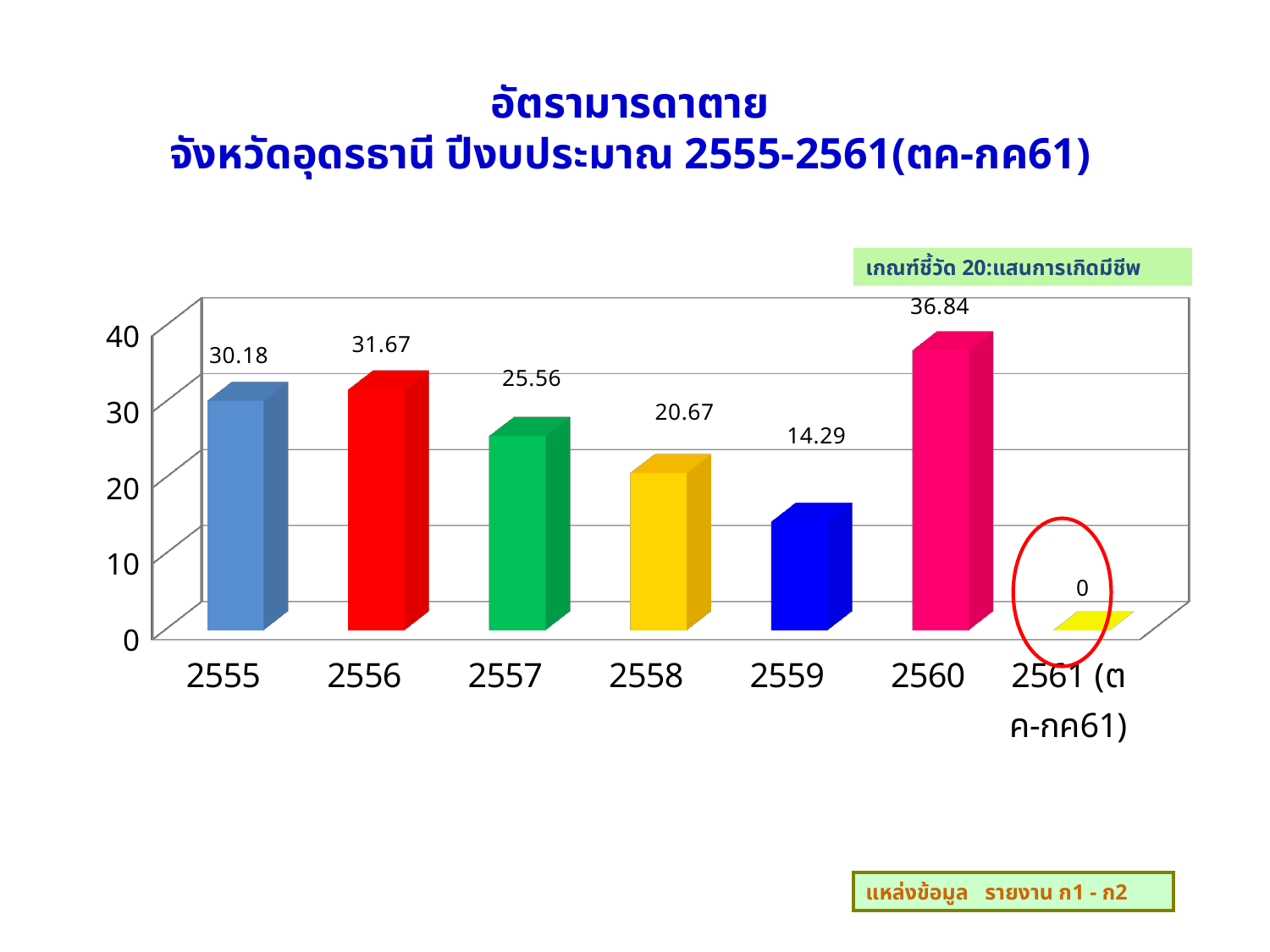
What is the value for 2560? 36.84 What kind of chart is shown on the slide? bar chart What is the value for 2558? 20.67 Which year has the highest value? 2560 Is the value for 2560 greater or less than 30? greater Do the values rise or fall from 2556 to 2559? fall Which is larger, the value for 2559 or the value for 2558? 2558 What is the value for 2555? 30.18 Which category has the lowest value? 2561 (ตค-กค61) How many categories are shown on the x axis? 7 What is the difference between the values for 2556 and 2557? 6.11 What is the value for 2561 (ตค-กค61)? 0